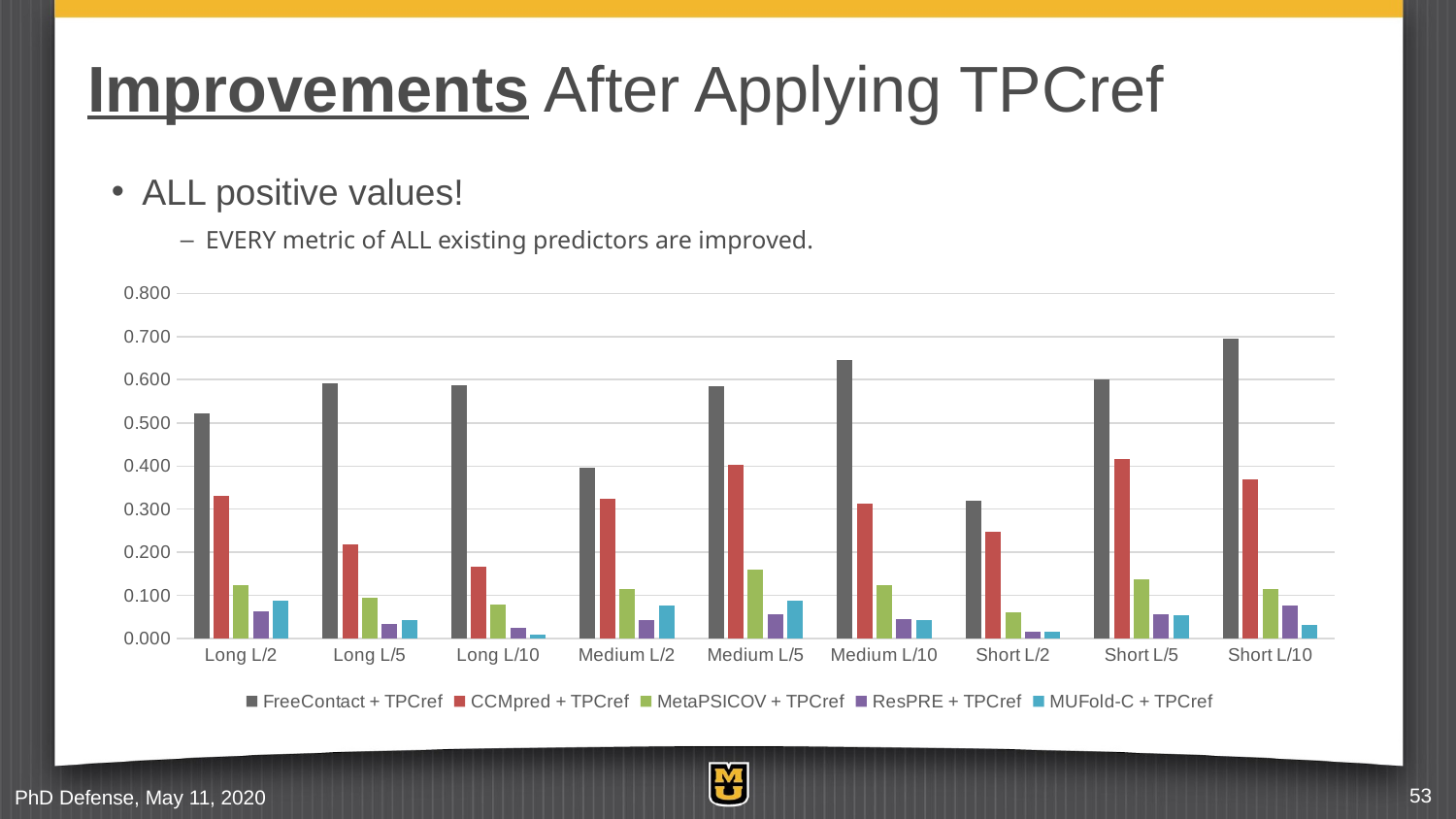
Which is larger at Long L/2: the MetaPSICOV + TPCref bar or the ResPRE + TPCref bar? MetaPSICOV + TPCref Is the FreeContact + TPCref value for Medium L/10 greater or less than 0.600? greater Is the CCMpred + TPCref value for Long L/5 greater or less than 0.300? less For which category is the FreeContact + TPCref bar the lowest? Short L/2 Is the MUFold-C + TPCref value for Long L/10 greater or less than 0.100? less How many categories are shown along the x axis of the chart? 9 For which category is the CCMpred + TPCref bar the lowest? Long L/10 For which category is the FreeContact + TPCref bar the highest? Short L/10 How many series does the chart's legend list? 5 What kind of chart is shown on the slide? bar chart Which series is shown in red in the chart's legend? CCMpred + TPCref Which is larger at Short L/2: the FreeContact + TPCref bar or the CCMpred + TPCref bar? FreeContact + TPCref